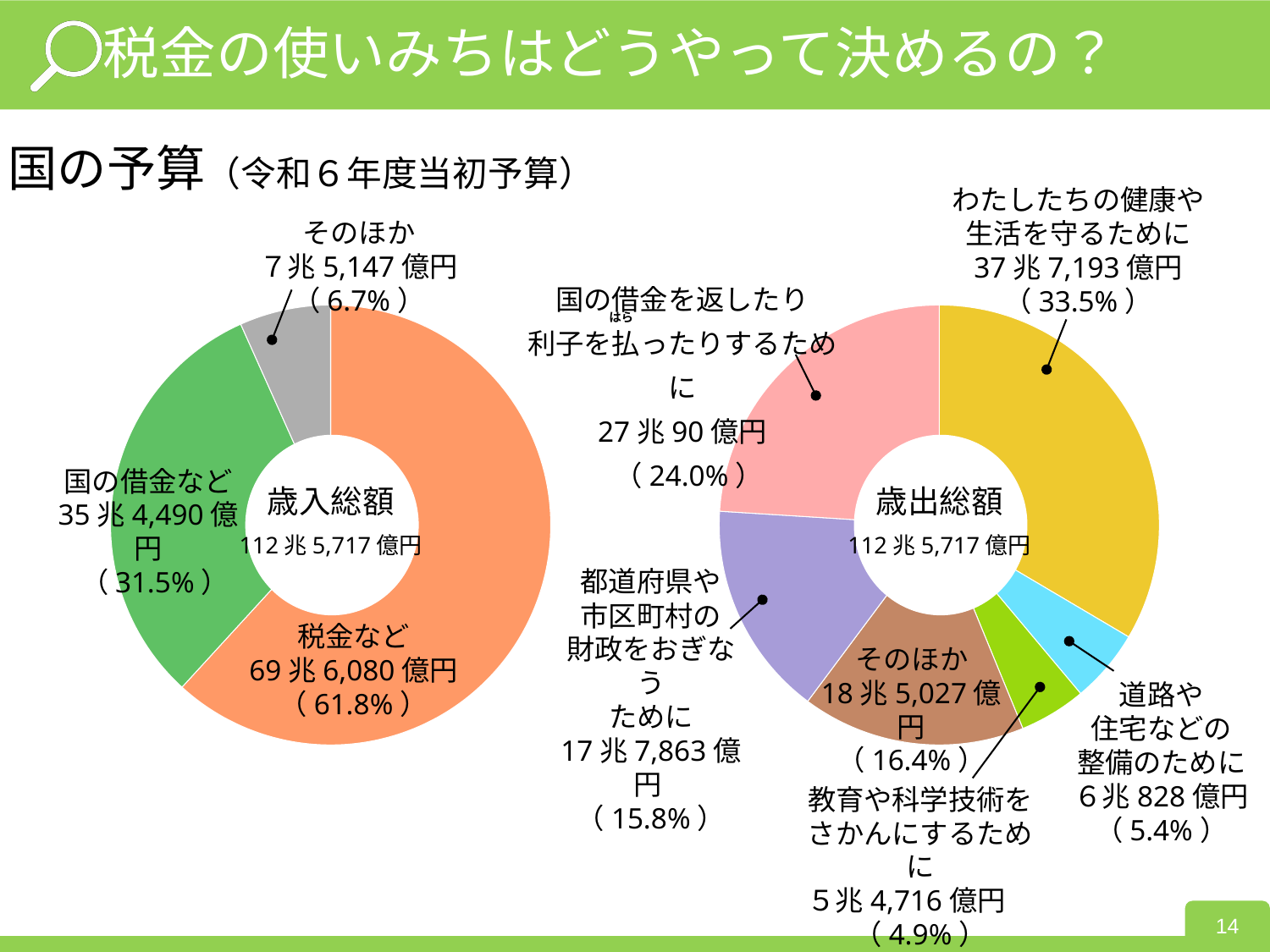
右の「歳出総額」のグラフで、「わたしたちの健康や生活を守るために」と「国の借金を返したり利子を払ったりするために」の割合の差は何ポイントですか？ 9.5ポイント 左の「歳入総額」のグラフには、いくつの項目がありますか？ 3 右の「歳出総額」のグラフで、最も割合が小さい項目はどれですか？ 教育や科学技術をさかんにするために このスライドのグラフはどのような種類のグラフですか？ 円グラフ（ドーナツグラフ） 右の「歳出総額」のグラフで、「わたしたちの健康や生活を守るために」の金額はいくらですか？ 37兆7,193億円 右の「歳出総額」のグラフで、「道路や住宅などの整備のために」の割合は何％ですか？ 5.4% 右の「歳出総額」のグラフで、「そのほか」と「都道府県や市区町村の財政をおぎなうために」では、どちらの割合が大きいですか？ そのほか 左の「歳入総額」のグラフで、「国の借金など」の割合は何％ですか？ 31.5% 右の「歳出総額」のグラフで、最も割合が大きい項目はどれですか？ わたしたちの健康や生活を守るために 左の「歳入総額」のグラフで、最も割合が小さい項目はどれですか？ そのほか 右の「歳出総額」のグラフには、いくつの項目がありますか？ 6 左の「歳入総額」のグラフで、「税金など」の金額はいくらですか？ 69兆6,080億円